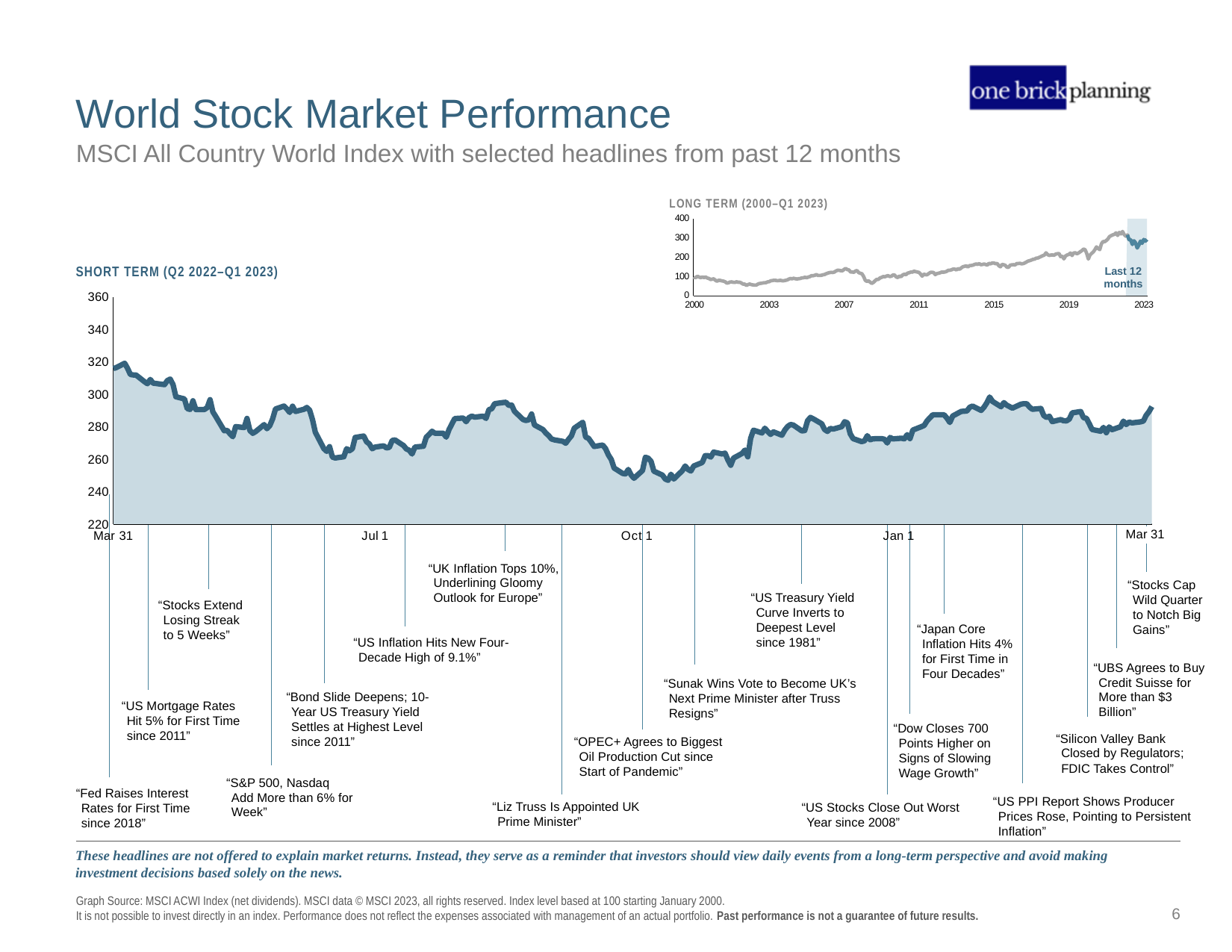
On the LONG TERM chart, is the value in 2023 greater or less than 200? greater On the SHORT TERM chart, is the value at the start (Mar 31, 2022) greater or less than 300? greater How many date labels are shown on the x axis of the SHORT TERM chart? 5 On the SHORT TERM chart, is the value at the end (Mar 31, 2023) greater or less than 280? greater On the LONG TERM chart, does the index overall rise or fall from 2000 to 2023? Rise On the SHORT TERM chart, does the index rise or fall between Mar 31 and Oct 1? Fall On the LONG TERM (2000–Q1 2023) chart, what is the index level at the start in 2000? 100 On the SHORT TERM chart, is the index higher at the start (Mar 31, 2022) or at the end (Mar 31, 2023)? Start (Mar 31, 2022) What label is given to the shaded region at the right end of the LONG TERM chart? Last 12 months What kind of chart is the SHORT TERM (Q2 2022–Q1 2023) chart? Line chart